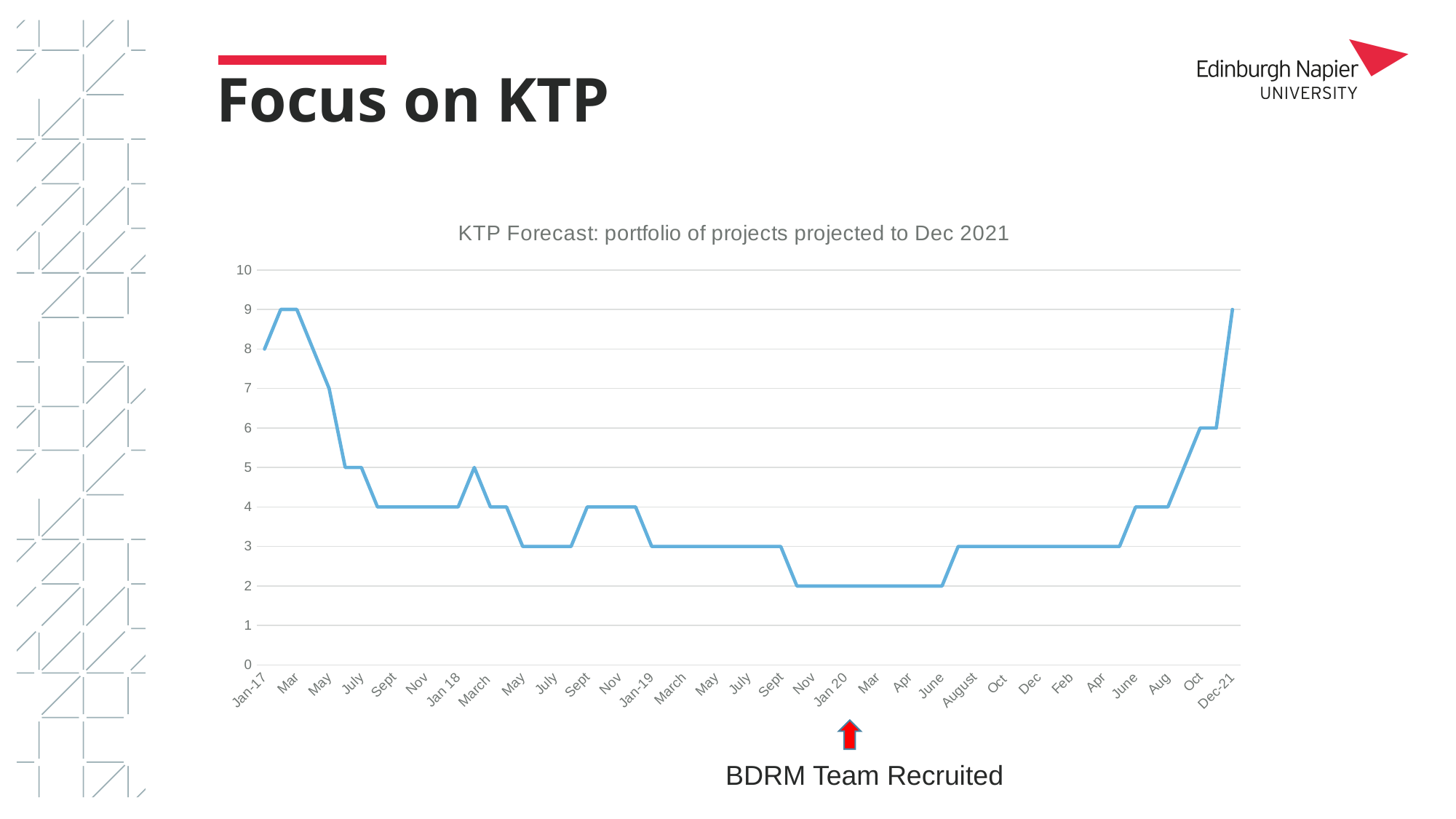
Which is larger, the value at Jan-17 or the value at Dec-21? Dec-21 What is the highest value the line reaches on the chart? 9 What is the value for Dec-21? 9 What is the value at Jan 20? 2 Which x-axis label does the red arrow labelled 'BDRM Team Recruited' point to? Jan 20 What is the value for Jan-17? 8 What is the value at Jan 18? 4 What is the difference between the value at Dec-21 and the value at Jan 20? 7 What kind of chart is shown on the slide? line chart Is the value at Jan 20 greater or less than 5? less What is the lowest value the line reaches on the chart? 2 What is the title of the chart? KTP Forecast: portfolio of projects projected to Dec 2021